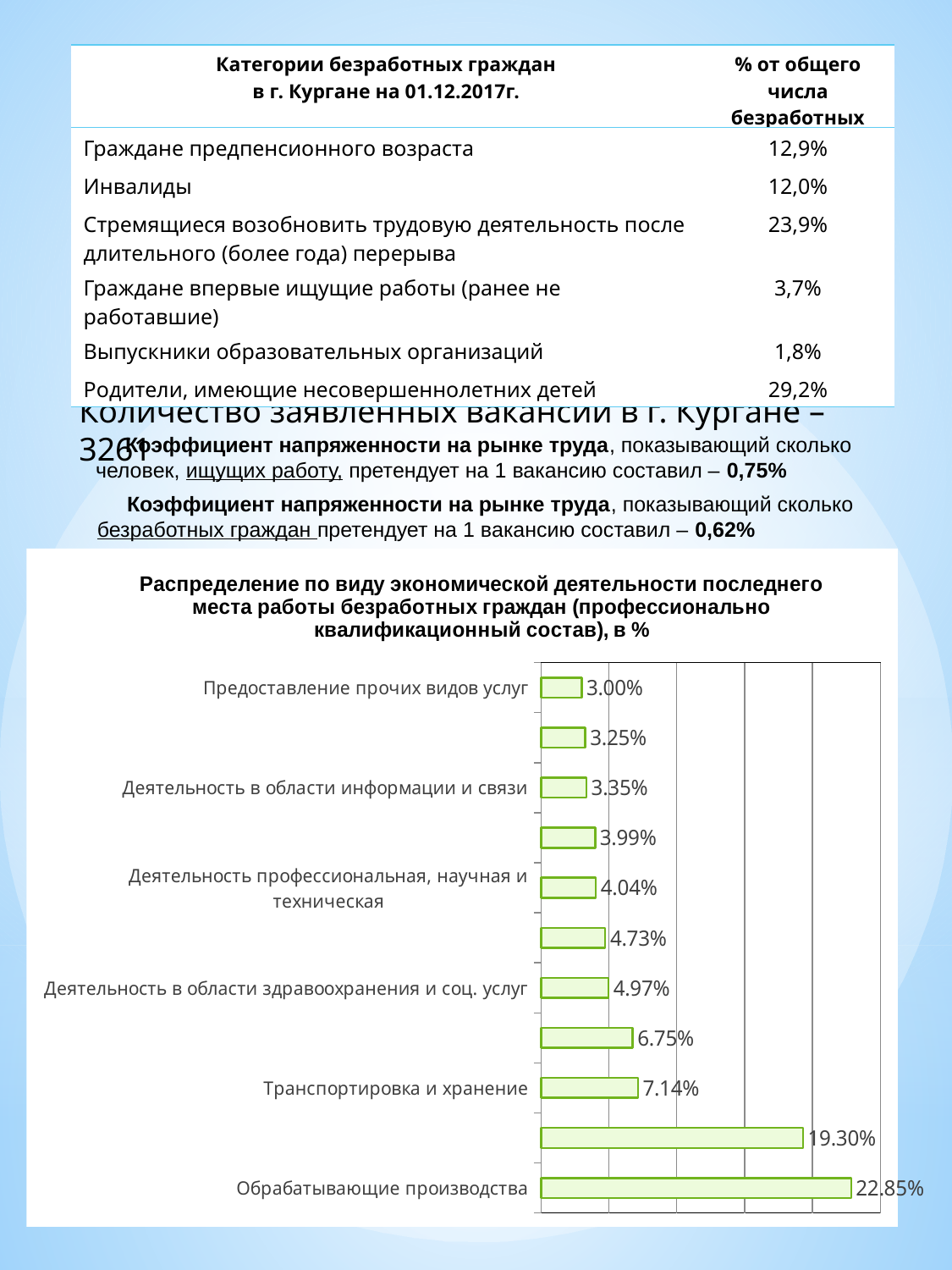
What is the value for Предоставление прочих видов услуг? 3.00% How many bars are plotted in the chart? 11 What is the value for Обрабатывающие производства? 22.85% Which labelled category has the lowest value? Предоставление прочих видов услуг What is the value for Деятельность профессиональная, научная и техническая? 4.04% Which category has the highest value? Обрабатывающие производства What is the difference between the values for Обрабатывающие производства and Транспортировка и хранение? 15.71% What is the value for Транспортировка и хранение? 7.14% What kind of chart is shown on the slide? bar chart Which is larger, the value for Транспортировка и хранение or the value for Деятельность в области здравоохранения и соц. услуг? Транспортировка и хранение What is the value for Деятельность в области информации и связи? 3.35% What is the value for Деятельность в области здравоохранения и соц. услуг? 4.97%